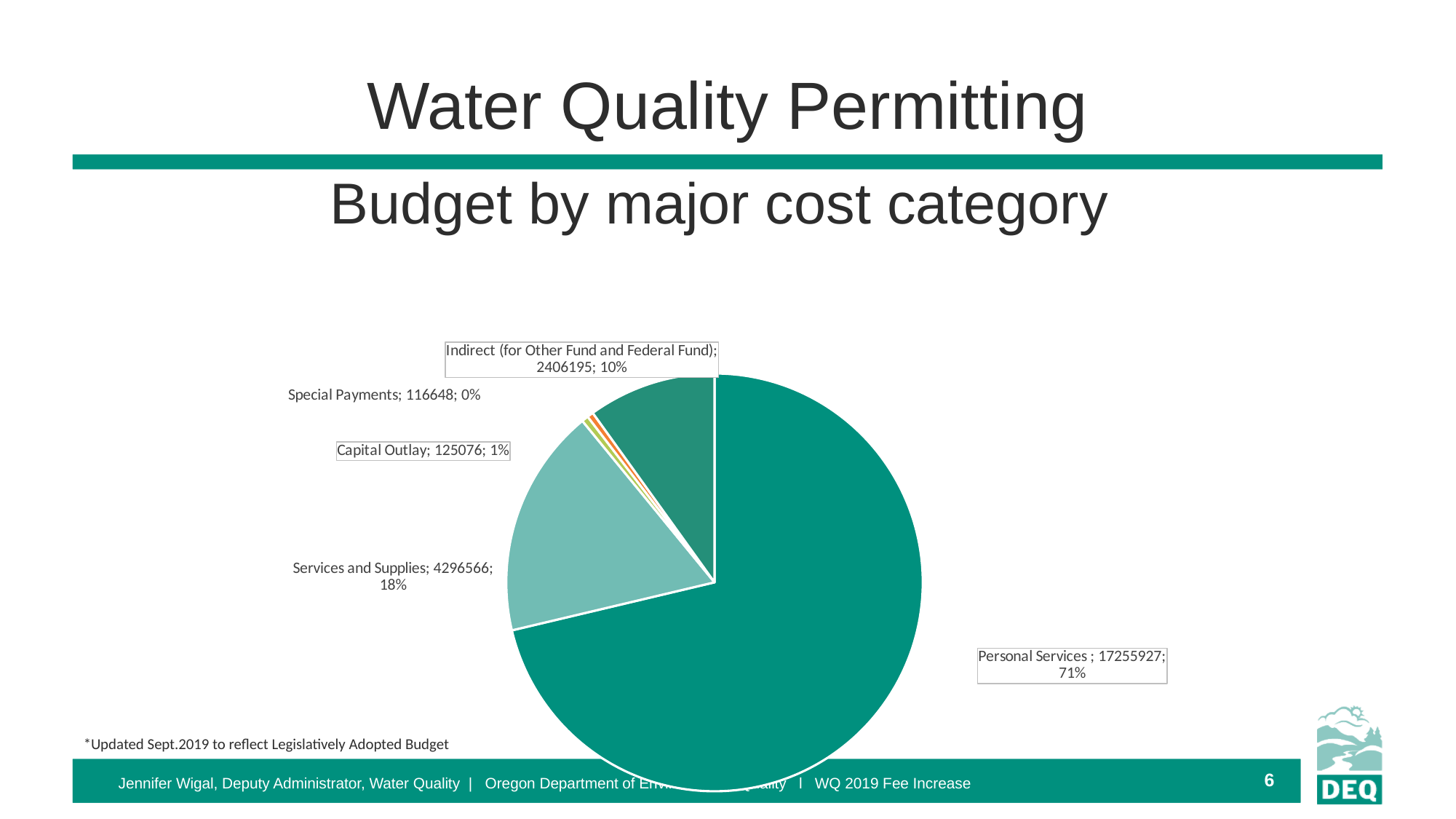
What is the value for Personal Services? 17255927 What share of the pie does Indirect (for Other Fund and Federal Fund) represent? 10% What is the value for Indirect (for Other Fund and Federal Fund)? 2406195 What kind of chart is shown on the slide? Pie chart How many categories are shown in the pie chart? 5 What is the value for Special Payments? 116648 Which category has the largest slice of the pie? Personal Services Which category has the smallest slice of the pie? Special Payments What is the value for Capital Outlay? 125076 What is the value for Services and Supplies? 4296566 What is the difference between the values for Personal Services and Services and Supplies? 12959361 What share of the pie does Services and Supplies represent? 18%